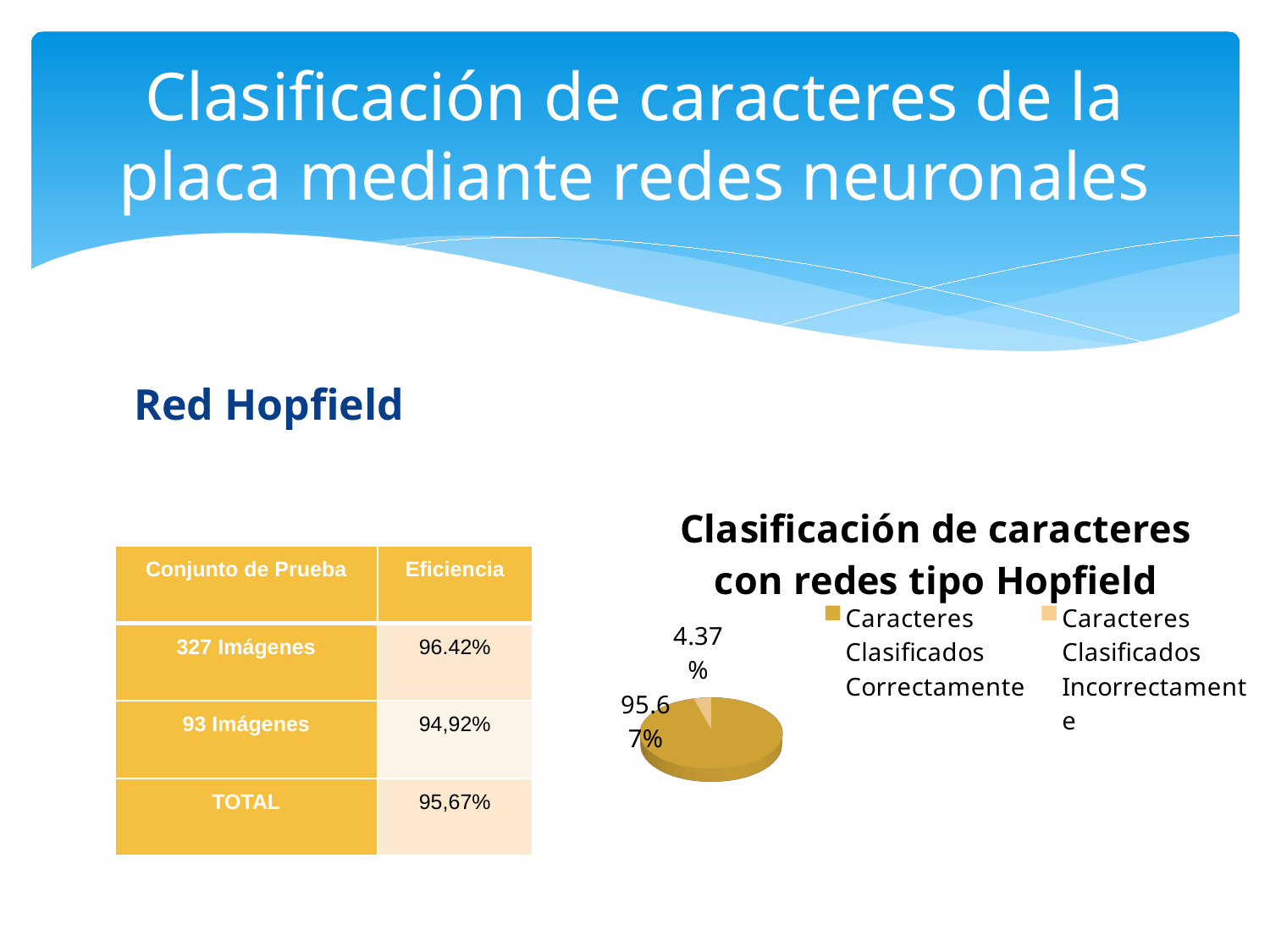
What is the difference between the two slice values in the pie chart? 91.30% Which slice of the pie chart is the largest? Caracteres Clasificados Correctamente What type of chart is shown on the slide? pie chart How many series does the pie chart legend list? 2 Which slice of the pie chart is the smallest? Caracteres Clasificados Incorrectamente How many slices does the pie chart have? 2 What colour is the Caracteres Clasificados Correctamente slice in the pie chart? dark gold What percentage is shown for Caracteres Clasificados Incorrectamente in the pie chart? 4.37% What percentage is shown for Caracteres Clasificados Correctamente in the pie chart? 95.67% Which is larger in the pie chart: Caracteres Clasificados Correctamente or Caracteres Clasificados Incorrectamente? Caracteres Clasificados Correctamente What is the title of the pie chart? Clasificación de caracteres con redes tipo Hopfield